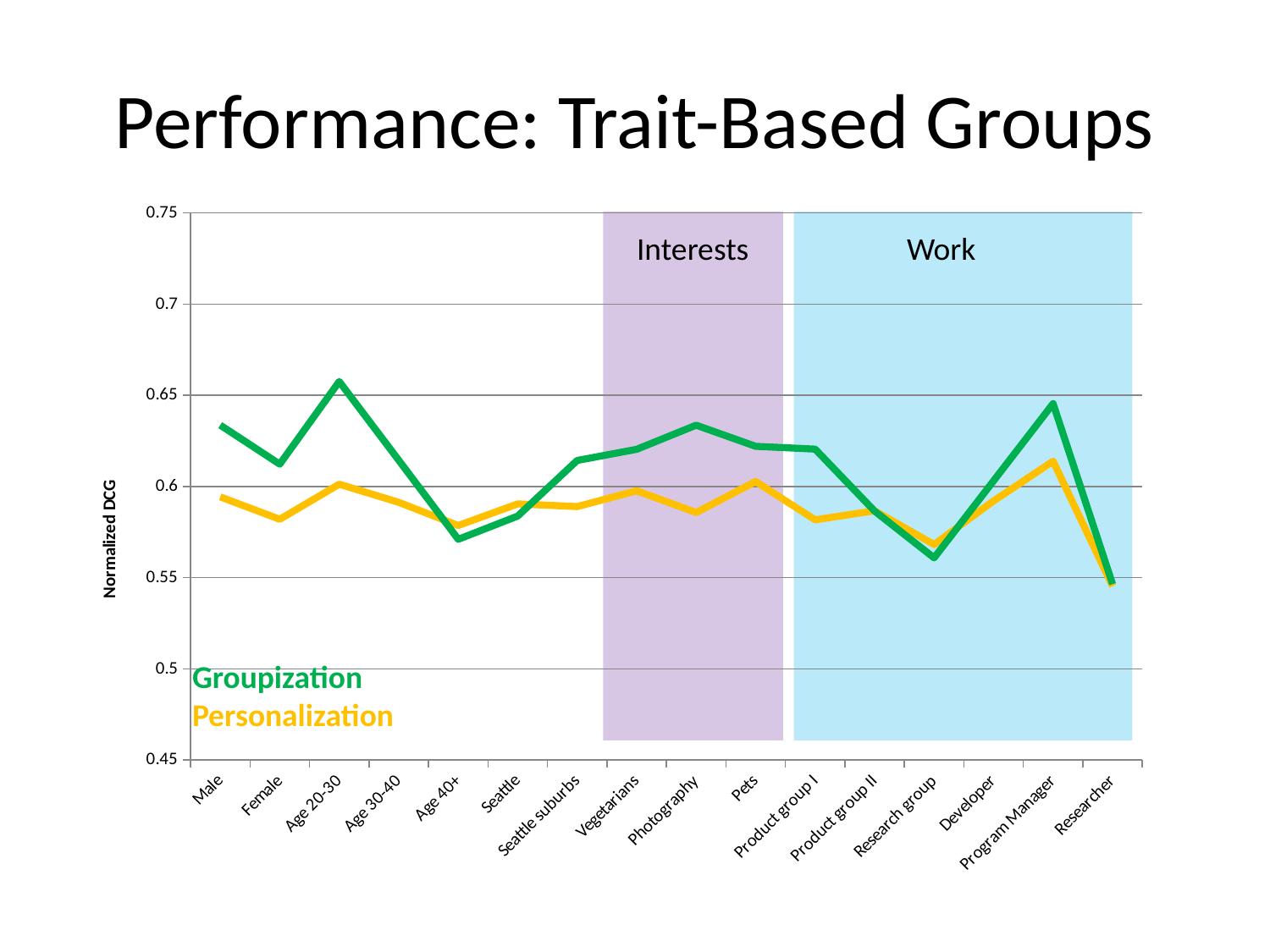
For Photography, which series has the larger value, Groupization or Personalization? Groupization How many series does the chart plot? 2 What kind of chart is shown on the slide? Line chart For which category is the Personalization value highest? Program Manager Which colour is used for the Groupization line? Green Is the Groupization value for Research group greater or less than 0.6? less What is the label of the y axis? Normalized DCG Is the Groupization value for Age 20-30 greater or less than 0.65? greater For which category is the Groupization value highest? Age 20-30 For which category is the Personalization value lowest? Researcher How many categories are shown along the x axis? 16 Is the Personalization value for Female greater or less than 0.6? less